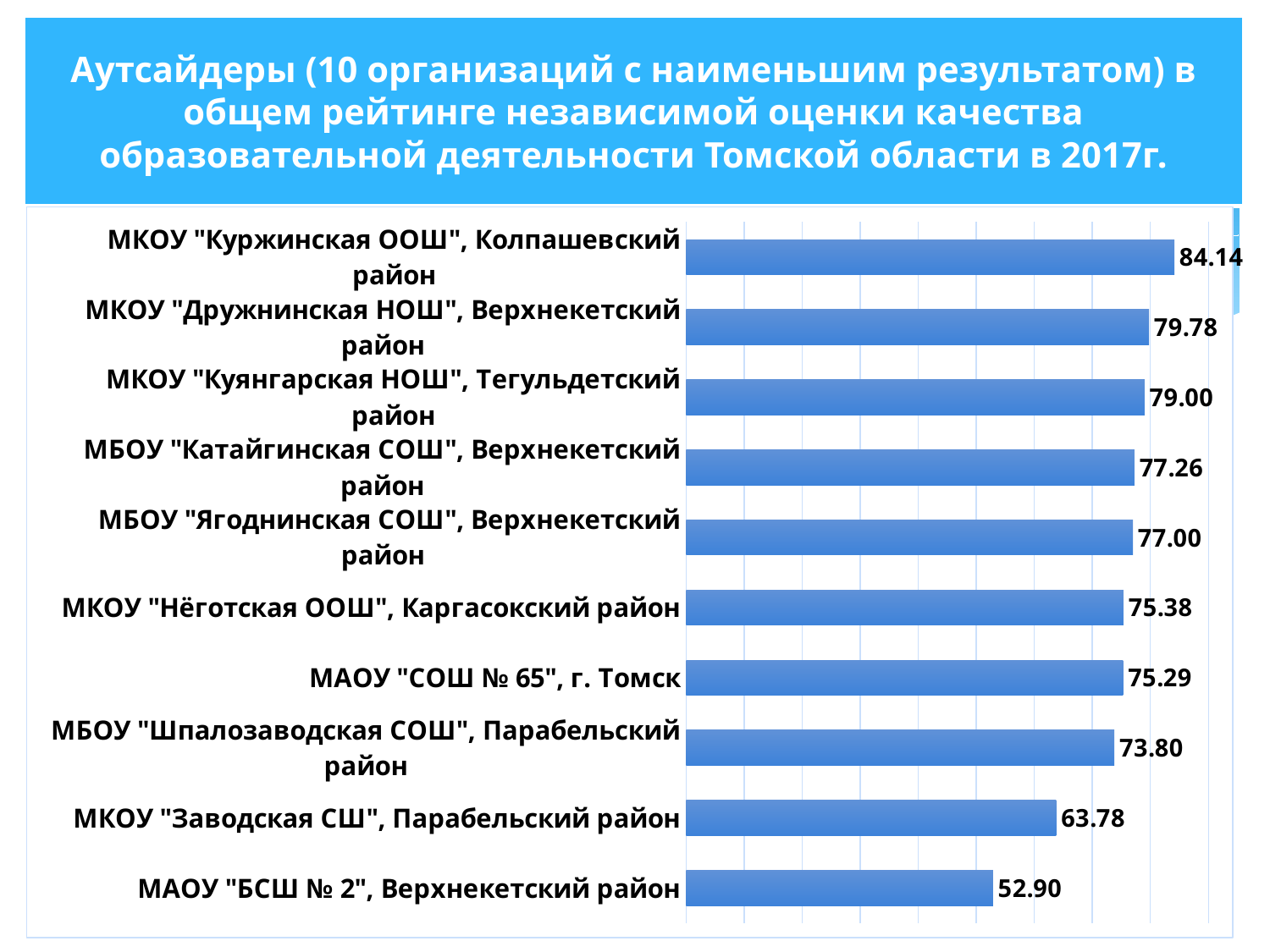
Do the values rise or fall going from the top bar to the bottom bar? fall What is the value for МКОУ "Заводская СШ", Парабельский район? 63.78 Which organization has the lowest value in the chart? МАОУ "БСШ № 2", Верхнекетский район How many organizations are shown in the chart? 10 Which has a larger value: МКОУ "Куянгарская НОШ", Тегульдетский район or МКОУ "Нёготская ООШ", Каргасокский район? МКОУ "Куянгарская НОШ", Тегульдетский район What is the value for МБОУ "Шпалозаводская СОШ", Парабельский район? 73.80 What is the difference between the values for МКОУ "Куржинская ООШ", Колпашевский район and МАОУ "БСШ № 2", Верхнекетский район? 31.24 What is the difference between the values for МКОУ "Заводская СШ", Парабельский район and МАОУ "БСШ № 2", Верхнекетский район? 10.88 What is the value for МКОУ "Куржинская ООШ", Колпашевский район? 84.14 Which organization has the highest value in the chart? МКОУ "Куржинская ООШ", Колпашевский район What is the value for МАОУ "СОШ № 65", г. Томск? 75.29 What type of chart is shown on the slide? bar chart